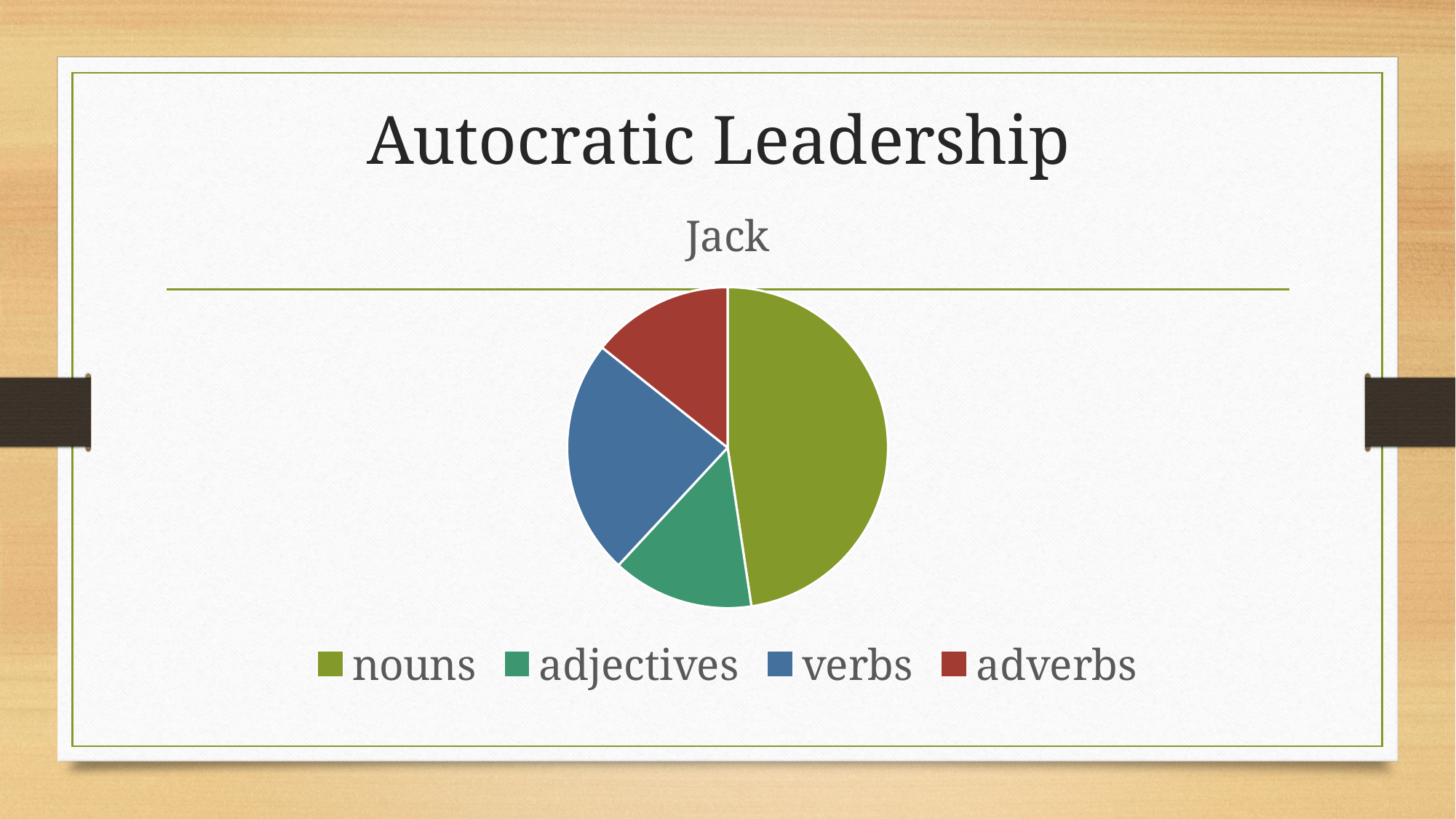
Which slice is larger, nouns or verbs? nouns Which slice is larger, verbs or adjectives? verbs What kind of chart is shown on the slide? pie chart Which category is shown in blue in the pie chart? verbs Which category has the largest slice of the pie? nouns Which slice is larger, verbs or adverbs? verbs What is the title of the chart? Jack Does the nouns slice take up more or less than half of the pie? less How many categories does the pie chart have? 4